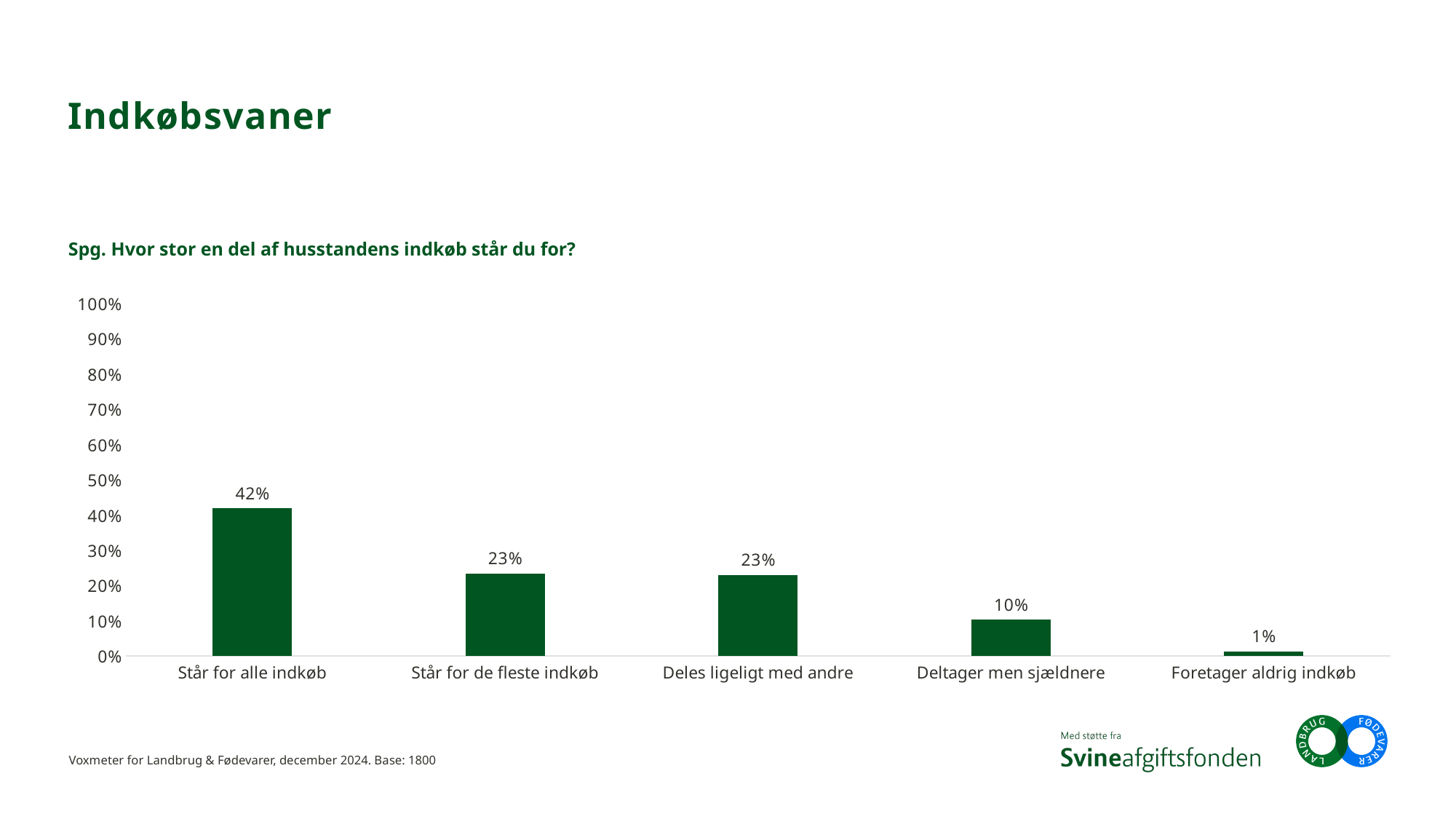
What is the value for "Deltager men sjældnere"? 10% What is the value for "Står for alle indkøb"? 42% What kind of chart is shown on the slide? Bar chart What is the value for "Foretager aldrig indkøb"? 1% What is the value for "Står for de fleste indkøb"? 23% What is the survey question shown above the chart? Spg. Hvor stor en del af husstandens indkøb står du for? Which category has the highest value? Står for alle indkøb Which category has the lowest value? Foretager aldrig indkøb How many categories are shown on the x axis? 5 What is the difference between the values for "Står for alle indkøb" and "Står for de fleste indkøb"? 19% Which is larger, the value for "Deles ligeligt med andre" or the value for "Deltager men sjældnere"? Deles ligeligt med andre Is the value for "Står for alle indkøb" greater or less than 50%? less